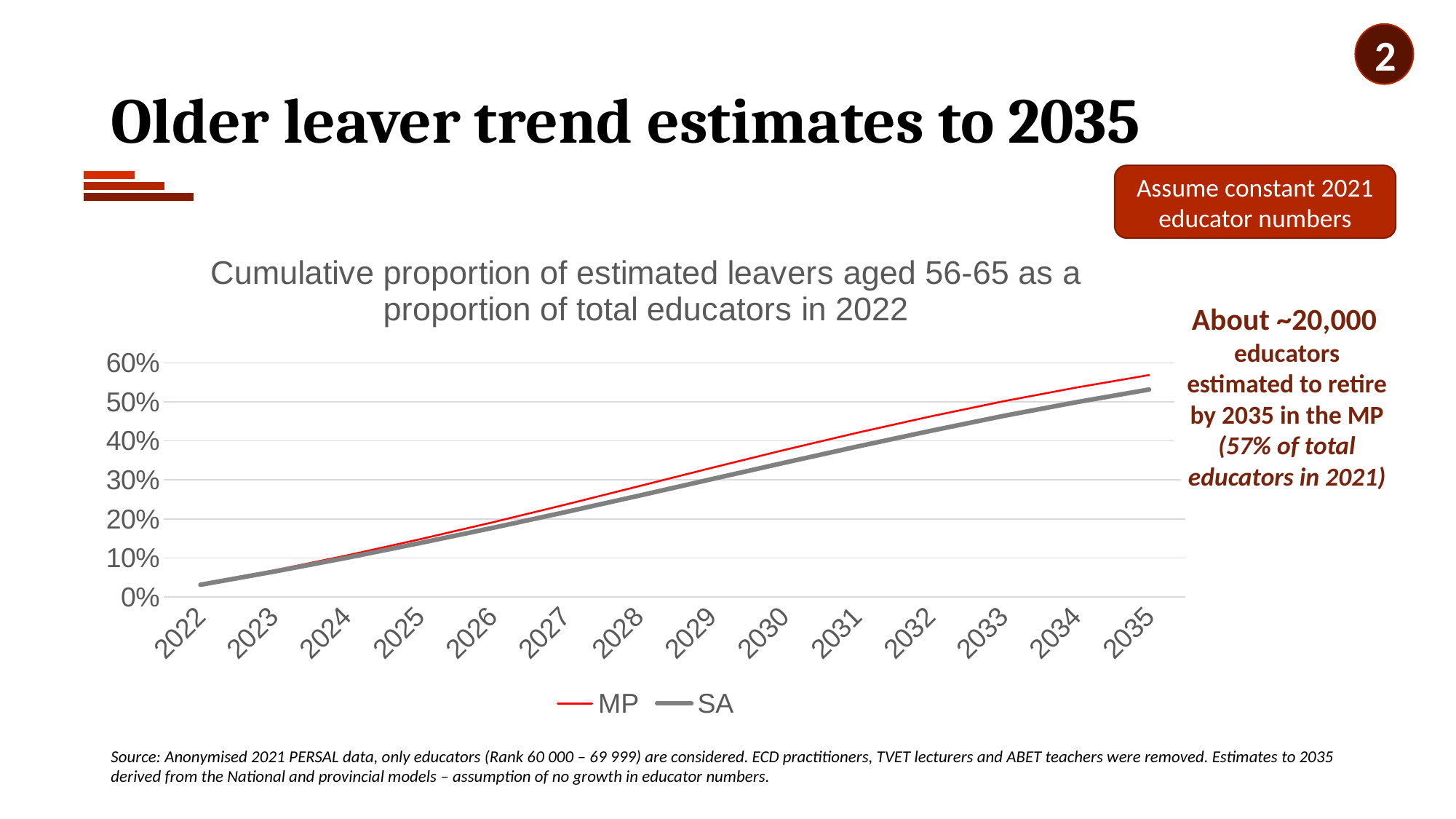
Is the value for SA in 2026 greater or less than 20%? less Do the values for MP rise or fall from 2022 to 2035? rise What colour is the line for the SA series? grey What kind of chart is shown on the slide? line chart Is the value for SA in 2022 greater or less than 10%? less Is the value for MP in 2035 greater or less than 50%? greater In 2035, which series has the higher value, MP or SA? MP What is the title of the chart? Cumulative proportion of estimated leavers aged 56-65 as a proportion of total educators in 2022 Do the values for SA rise or fall from 2022 to 2035? rise How many years are shown along the x axis? 14 How many series does the legend list? 2